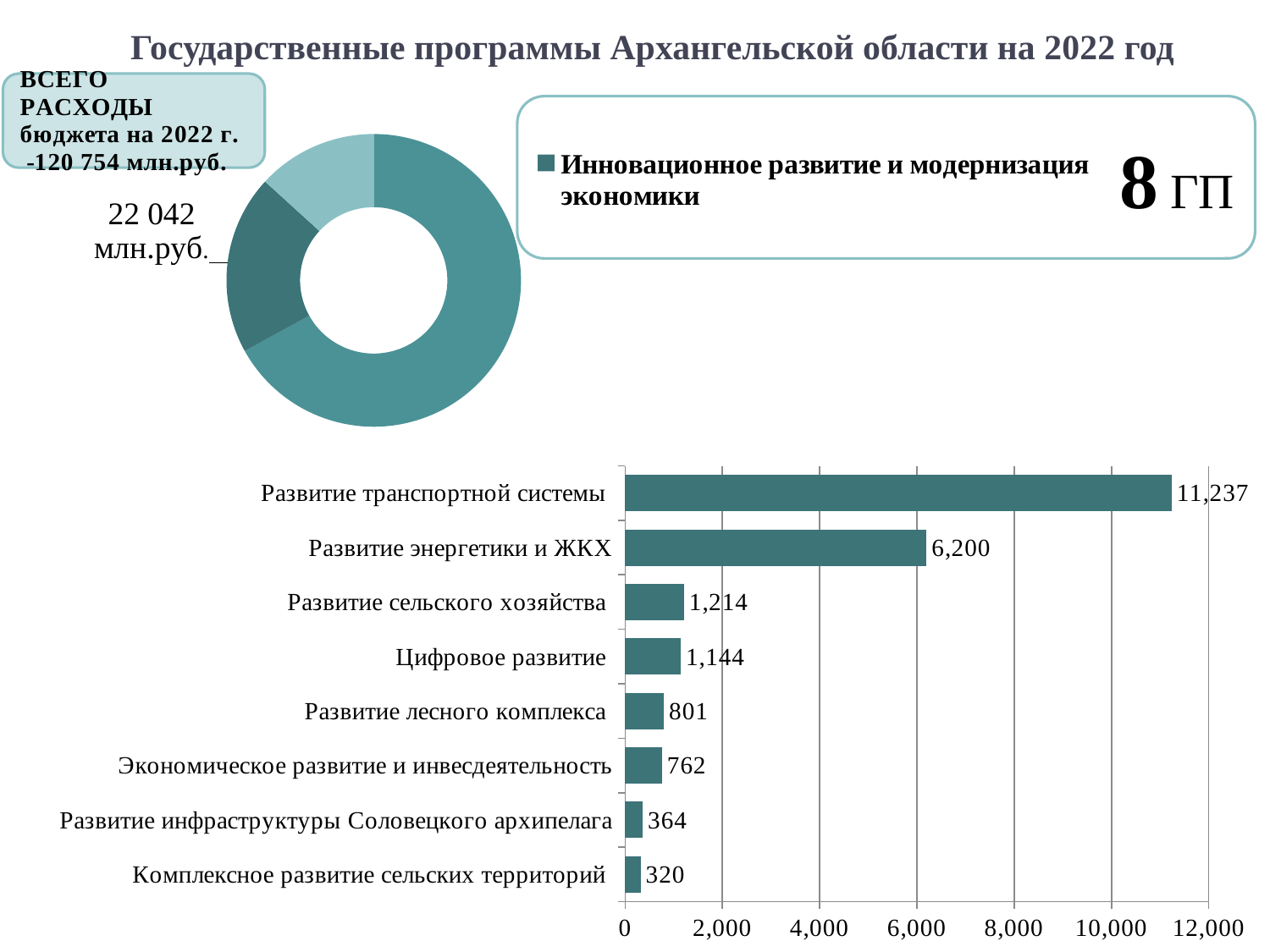
In the bar chart, what is the difference between Развитие сельского хозяйства and Цифровое развитие? 70 In the bar chart, what is the value for Развитие транспортной системы? 11,237 In the bar chart, which category has the lowest value? Комплексное развитие сельских территорий In the bar chart, what is the difference between Развитие транспортной системы and Развитие энергетики и ЖКХ? 5,037 How many categories does the bar chart show? 8 In the bar chart, what is the value for Развитие инфраструктуры Соловецкого архипелага? 364 In the bar chart, what is the value for Развитие лесного комплекса? 801 What kind of chart is the chart at the bottom of the slide? bar chart In the bar chart, is the value for Развитие энергетики и ЖКХ greater or less than 4,000? greater In the bar chart, which category has the highest value? Развитие транспортной системы In the bar chart, which is larger: Развитие лесного комплекса or Экономическое развитие и инвесдеятельность? Развитие лесного комплекса What value is labelled on the doughnut chart at the top of the slide? 22 042 млн.руб.